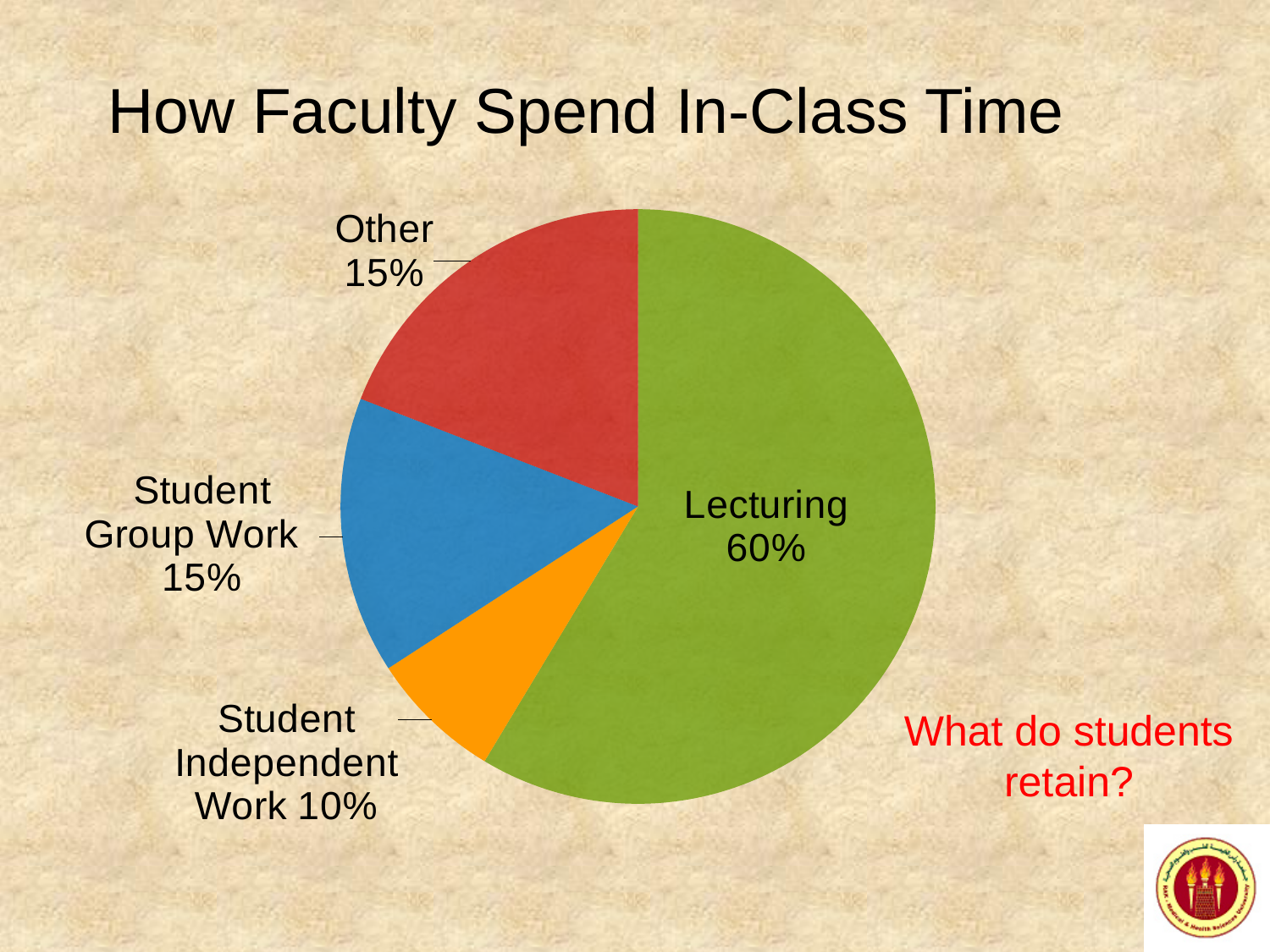
Which category takes the largest share of in-class time? Lecturing Which category takes the smallest share of in-class time? Student Independent Work What is the difference in percentage points between Lecturing and Student Group Work? 45 What kind of chart is shown on the slide? pie chart Which is larger, the share for Student Group Work or the share for Student Independent Work? Student Group Work What is the title of the chart? How Faculty Spend In-Class Time What share of in-class time is spent on Lecturing? 60% What share of in-class time is labelled Other? 15% What share of in-class time is spent on Student Independent Work? 10% How many slices does the pie chart have? 4 What share of in-class time is spent on Student Group Work? 15% What colour is the Lecturing slice? green